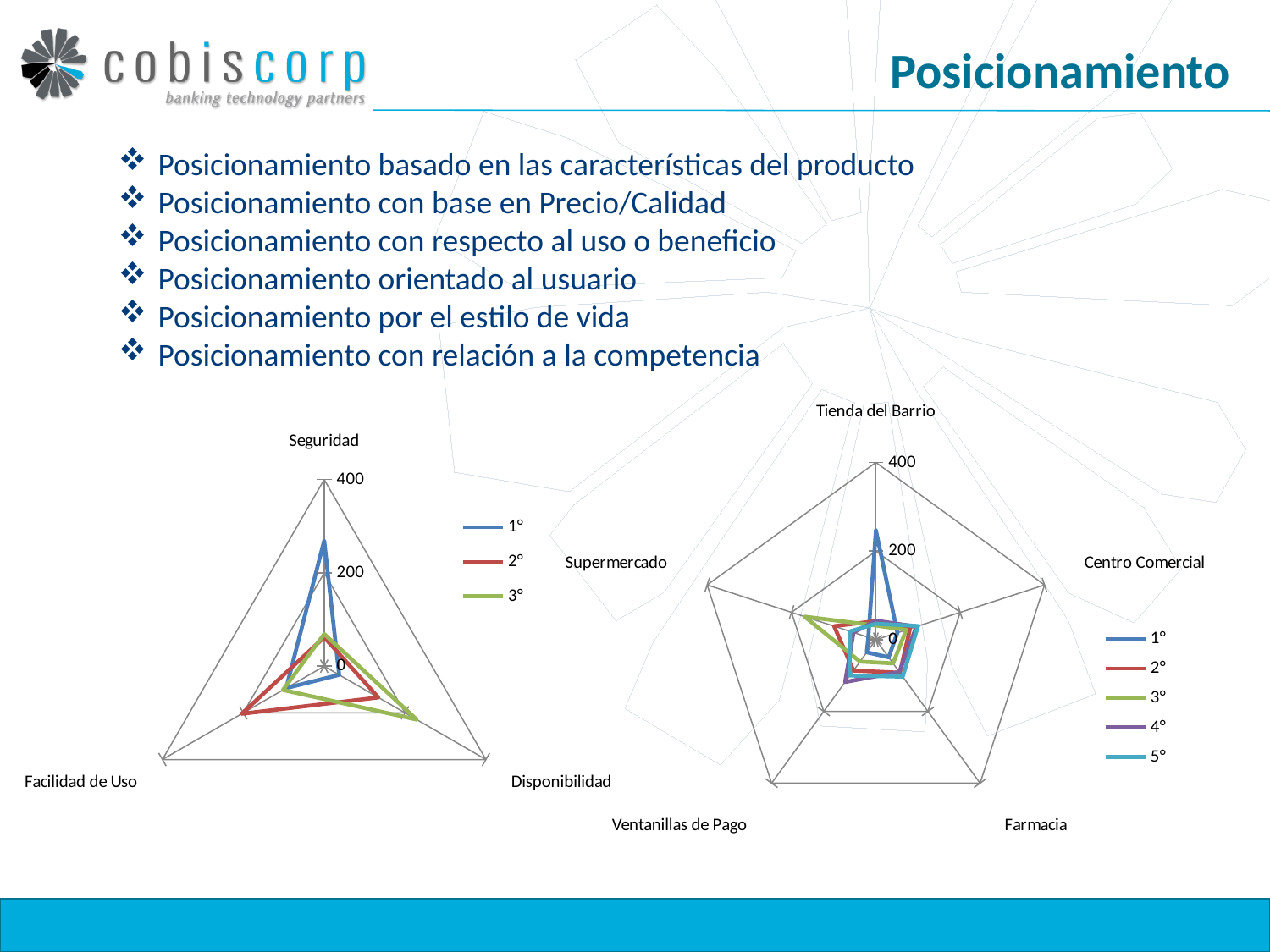
In the left chart, which series has the highest value for Seguridad? 1° In the left chart, which series has the highest value for Facilidad de Uso? 2° What kind of chart is the chart on the right of the slide? radar chart In the left chart, how many categories (axes) are plotted? 3 In the right chart, is the value of series 1° for Tienda del Barrio greater or less than 200? greater In the left chart, is the value of series 1° for Seguridad greater or less than 200? greater In the right chart, which series has the highest value for Supermercado? 3° What kind of chart is the chart on the left of the slide? radar chart How many series does the legend of the left chart list? 3 In the right chart, how many categories (axes) are plotted? 5 How many series does the legend of the right chart list? 5 In the left chart, is the value of series 2° for Seguridad greater or less than 200? less